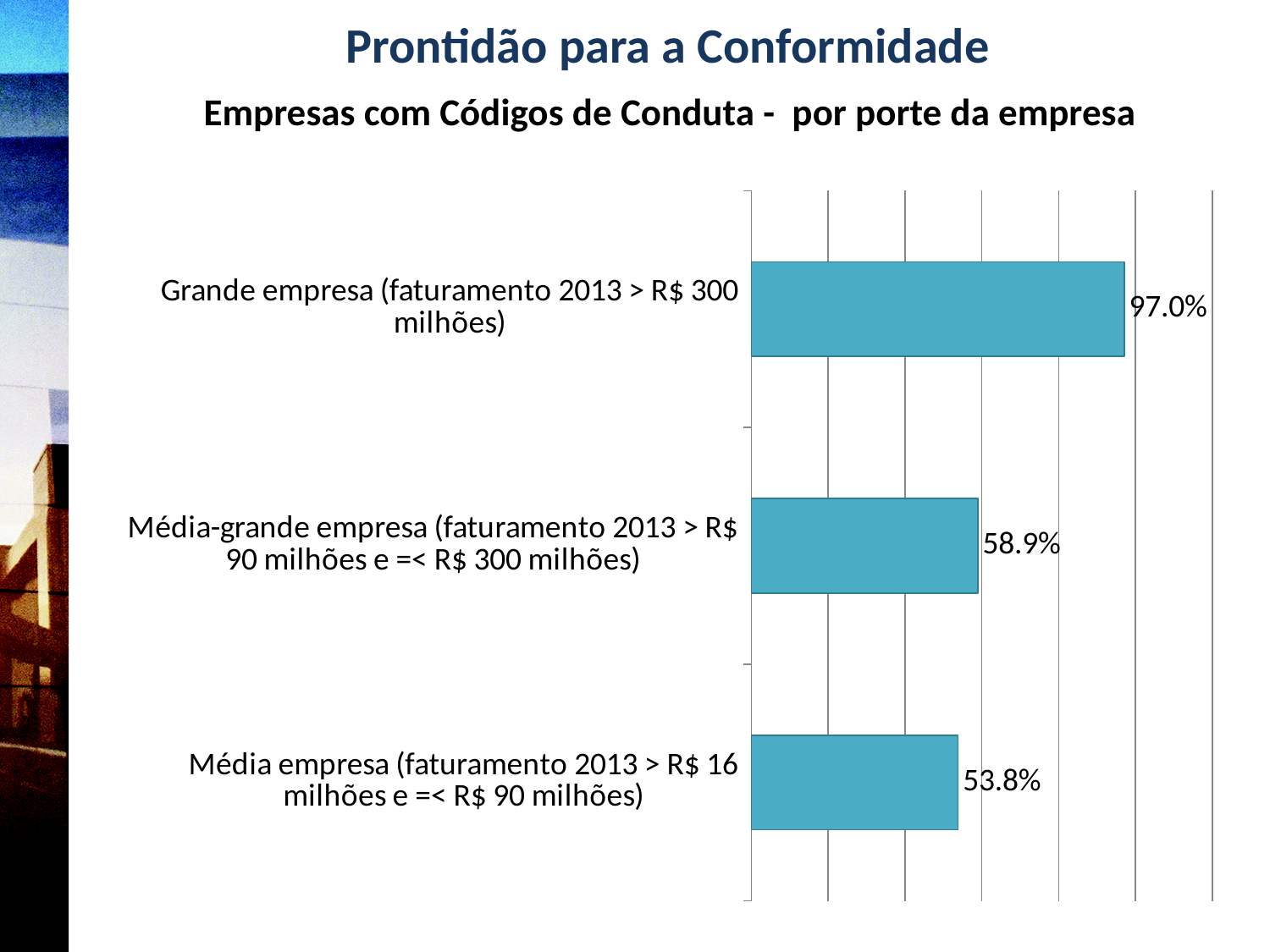
Which company size category has the lowest share of companies with codes of conduct? Média empresa What is the subtitle of the chart on the slide? Empresas com Códigos de Conduta - por porte da empresa What is the difference in percentage points between Média-grande empresa and Média empresa? 5.1 What type of chart is shown on the slide? Bar chart What is the difference in percentage points between Grande empresa and Média empresa? 43.2 How many company size categories are shown in the chart? 3 What percentage of large companies (Grande empresa) have codes of conduct? 97.0% What colour are the bars in the chart? Blue Which is larger, the value for Grande empresa or the value for Média-grande empresa? Grande empresa What is the value shown for Média-grande empresa? 58.9% What is the value shown for Média empresa? 53.8% Which company size category has the highest share of companies with codes of conduct? Grande empresa